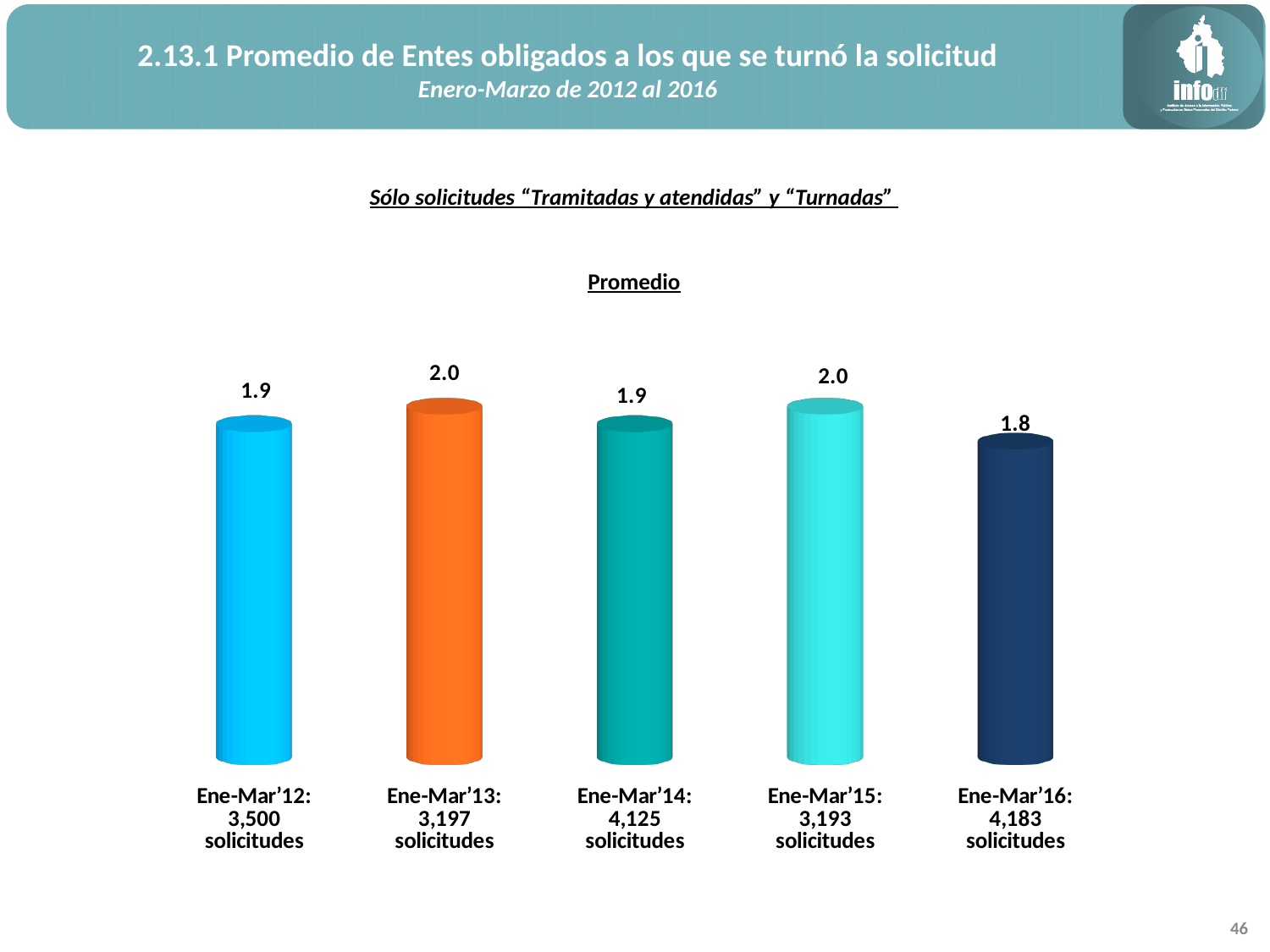
What is the average value shown for Ene-Mar'16? 1.8 What is the average value shown for Ene-Mar'13? 2.0 Which period has the lowest average value? Ene-Mar'16 How many solicitudes are indicated in the label for Ene-Mar'14? 4,125 What colour is the bar for Ene-Mar'13? Orange How many periods (bars) are shown in the chart? 5 What is the difference between the average values for Ene-Mar'13 and Ene-Mar'16? 0.2 What kind of chart is shown on the slide? Bar chart What is the average value shown for Ene-Mar'15? 2.0 What is the average (Promedio) value shown for Ene-Mar'12? 1.9 Which is larger, the average value for Ene-Mar'14 or for Ene-Mar'16? Ene-Mar'14 What is the title shown above the chart? Promedio